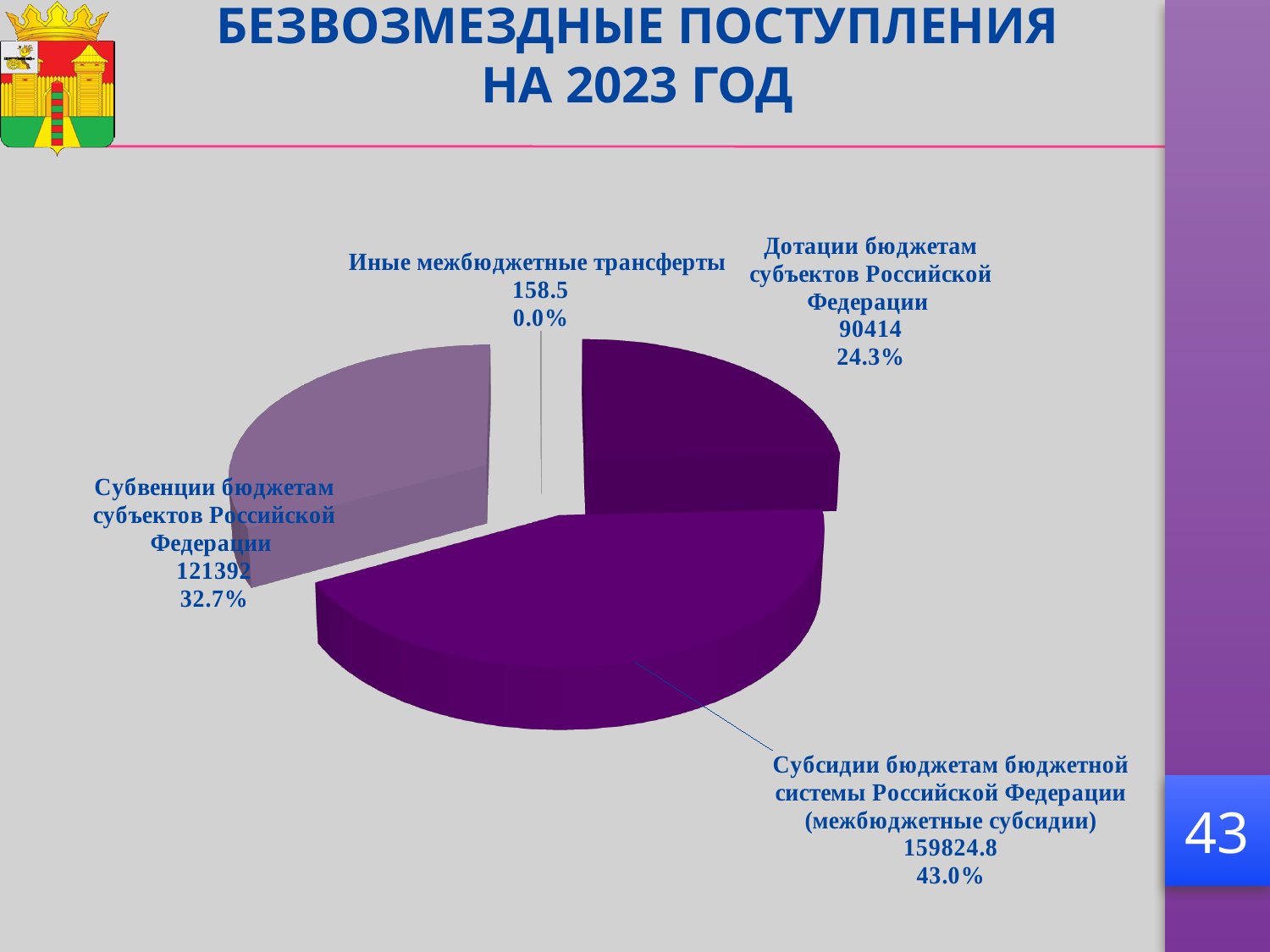
How many categories does the pie chart show? 4 What is the value for Дотации бюджетам субъектов Российской Федерации? 90414 What share of the pie does Субвенции бюджетам субъектов Российской Федерации represent? 32.7% What kind of chart is shown on the slide? Pie chart What is the value for Иные межбюджетные трансферты? 158.5 What share of the pie does Дотации бюджетам субъектов Российской Федерации represent? 24.3% What is the difference between the values for Субвенции бюджетам субъектов Российской Федерации and Дотации бюджетам субъектов Российской Федерации? 30978 Which category has the smallest value? Иные межбюджетные трансферты What is the value for Субвенции бюджетам субъектов Российской Федерации? 121392 What is the value for Субсидии бюджетам бюджетной системы Российской Федерации (межбюджетные субсидии)? 159824.8 Which category has the largest value? Субсидии бюджетам бюджетной системы Российской Федерации (межбюджетные субсидии) What is the title of the slide? БЕЗВОЗМЕЗДНЫЕ ПОСТУПЛЕНИЯ НА 2023 ГОД